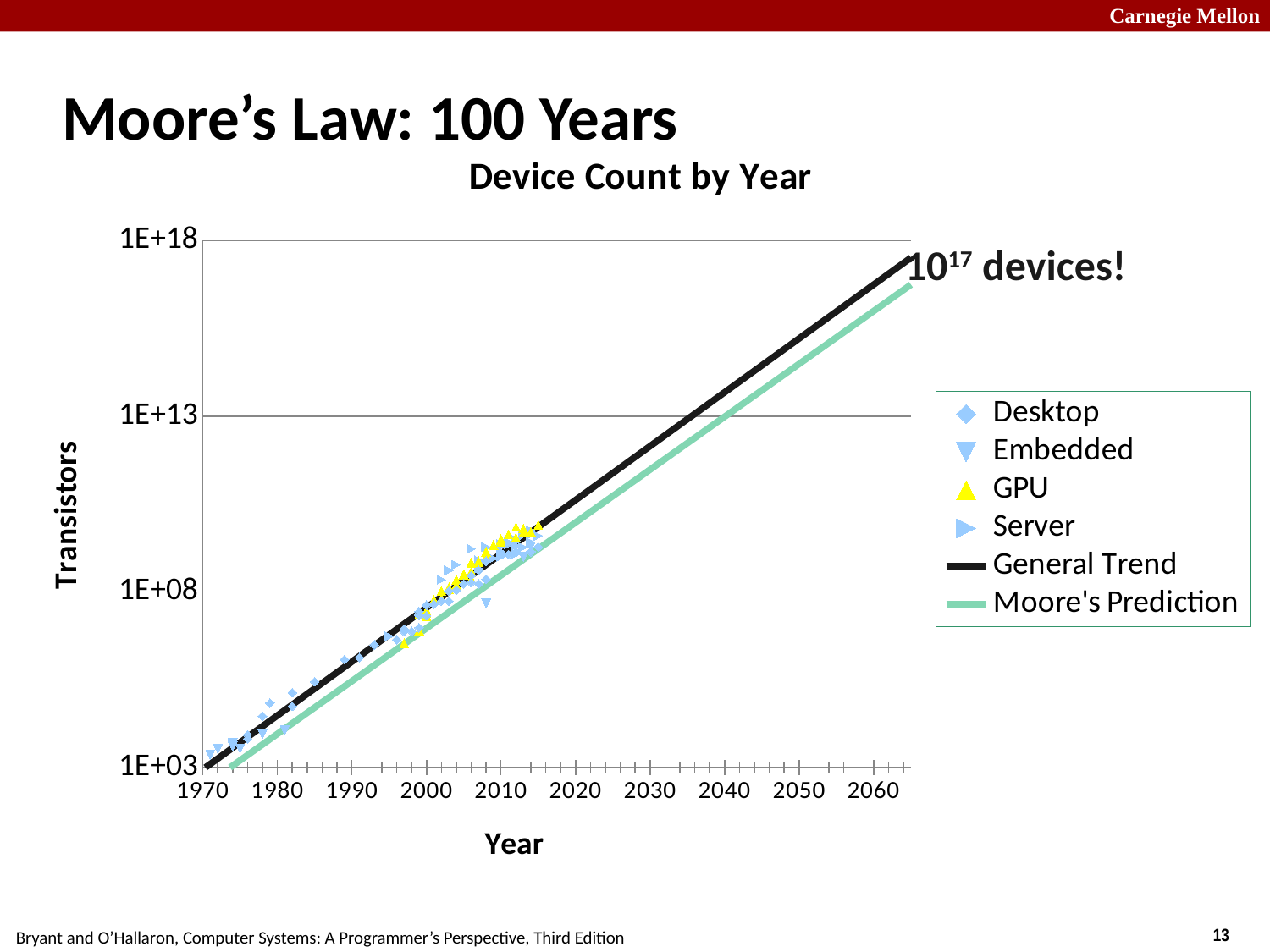
Which legend series is shown with yellow triangle markers? GPU Do the transistor counts rise or fall as the year increases along the x axis? Rise What is the title of the chart? Device Count by Year Is the General Trend value at 1990 greater or less than 1E+08? less Is the Moore's Prediction value at 2020 greater or less than 1E+08? greater Is the General Trend value at 2060 greater or less than 1E+13? greater How many series does the chart legend list? 6 What is the highest value shown on the y axis? 1E+18 Which line is higher at the year 2040, General Trend or Moore's Prediction? General Trend What is the label of the y axis? Transistors What kind of chart is shown on the slide? Scatter chart with trend lines